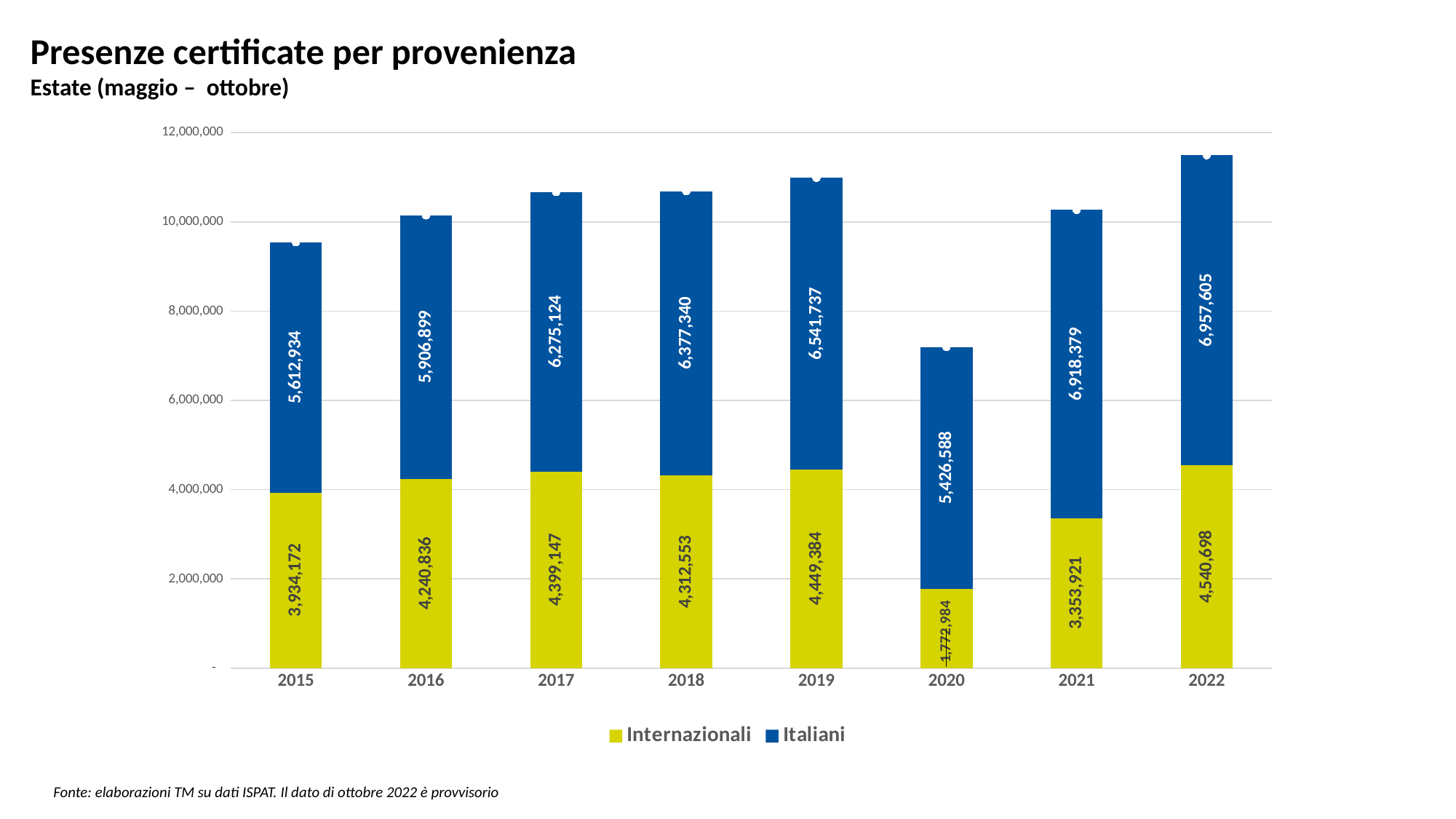
Which year has the lowest Internazionali value? 2020 What is the Internazionali value for 2015? 3,934,172 Which is larger, the Internazionali value for 2017 or for 2018? 2017 What is the total of the stacked bar for 2022? 11,498,303 How many series does the legend list? 2 What is the Italiani value for 2019? 6,541,737 What is the Internazionali value for 2020? 1,772,984 What is the difference between the Internazionali values for 2019 and 2018? 136,831 What is the difference between the Italiani values for 2022 and 2021? 39,226 What is the total of the stacked bar for 2020? 7,199,572 Which year has the highest Italiani value? 2022 How many years are shown on the x axis? 8